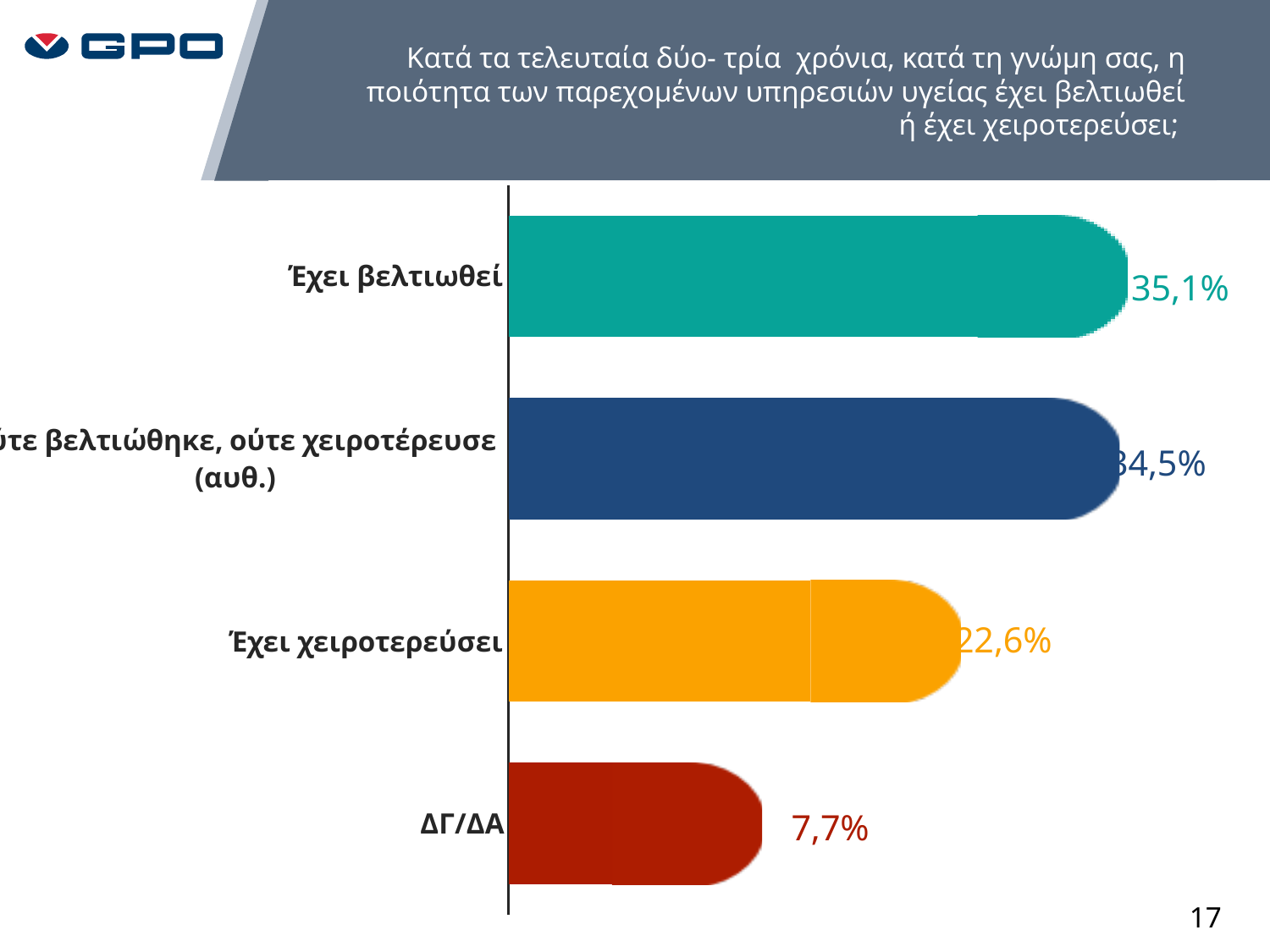
What percentage of respondents answered "Έχει βελτιωθεί"? 35,1% What is the value shown for "Έχει χειροτερεύσει"? 22,6% What colour is the bar for "Έχει χειροτερεύσει"? Orange How many categories are shown in the chart? 4 Which is larger: the value for "Έχει χειροτερεύσει" or the value for "ΔΓ/ΔΑ"? Έχει χειροτερεύσει Which category has the lowest value? ΔΓ/ΔΑ What is the difference between the values for "Έχει χειροτερεύσει" and "ΔΓ/ΔΑ"? 14,9% What is the value shown for "ΔΓ/ΔΑ"? 7,7% What is the difference between the values for "Έχει βελτιωθεί" and "Έχει χειροτερεύσει"? 12,5% What is the value shown for "Ούτε βελτιώθηκε, ούτε χειροτέρευσε (αυθ.)"? 34,5% Which category has the highest value? Έχει βελτιωθεί What kind of chart is shown on the slide? Bar chart